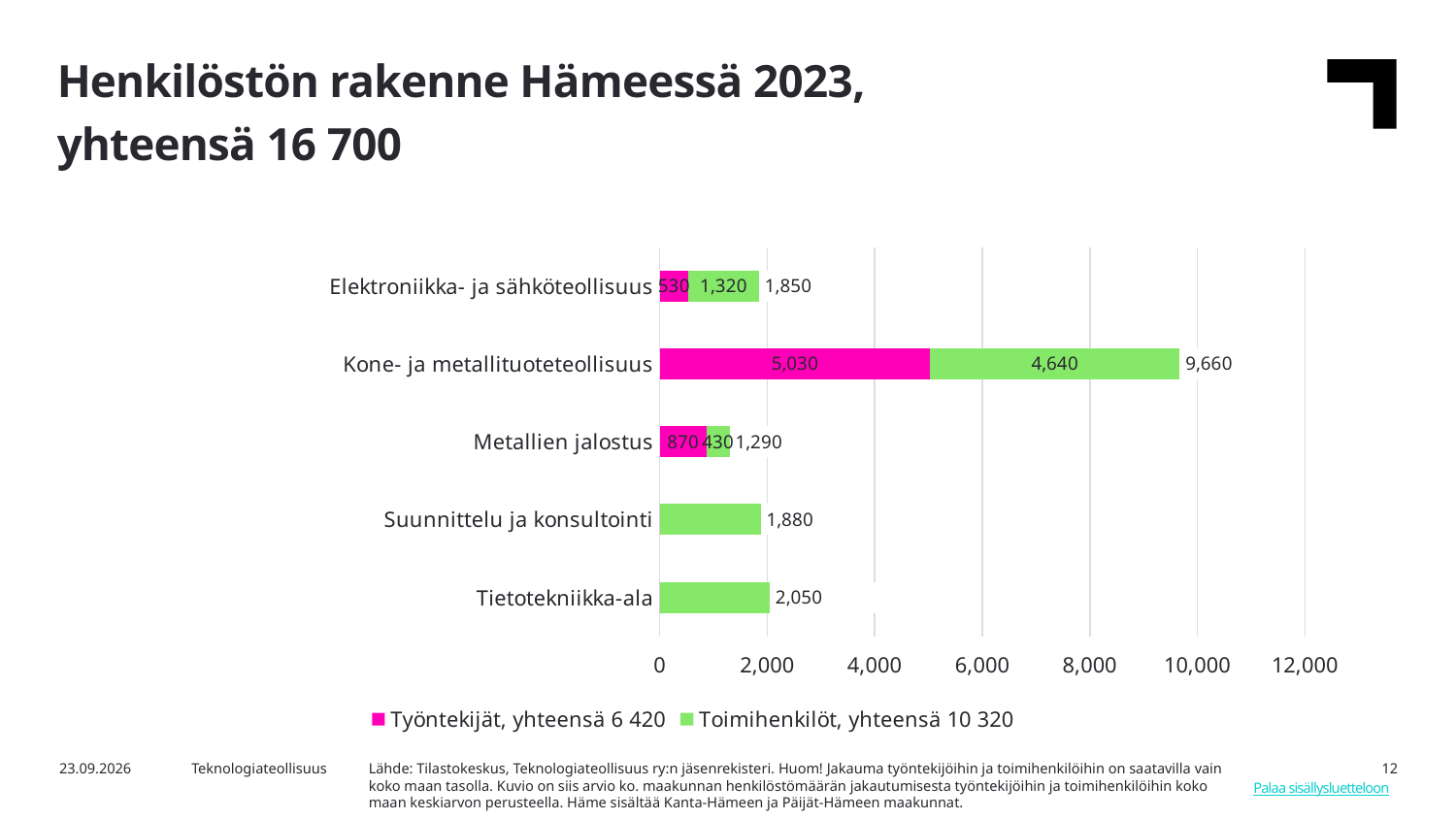
Is the total for Kone- ja metallituoteteollisuus greater or less than 8,000? greater What type of chart is shown on the slide? Stacked bar chart Which is larger, the total for Tietotekniikka-ala or the total for Suunnittelu ja konsultointi? Tietotekniikka-ala How many categories are shown on the chart? 5 How many series does the legend list? 2 Which category has the highest total? Kone- ja metallituoteteollisuus What is the Työntekijät value for Kone- ja metallituoteteollisuus? 5,030 Which category has the lowest total? Metallien jalostus What is the total shown for Metallien jalostus? 1,290 What is the Toimihenkilöt value for Elektroniikka- ja sähköteollisuus? 1,320 What is the title of the chart on the slide? Henkilöstön rakenne Hämeessä 2023, yhteensä 16 700 What is the difference between the Työntekijät and Toimihenkilöt values for Kone- ja metallituoteteollisuus? 390